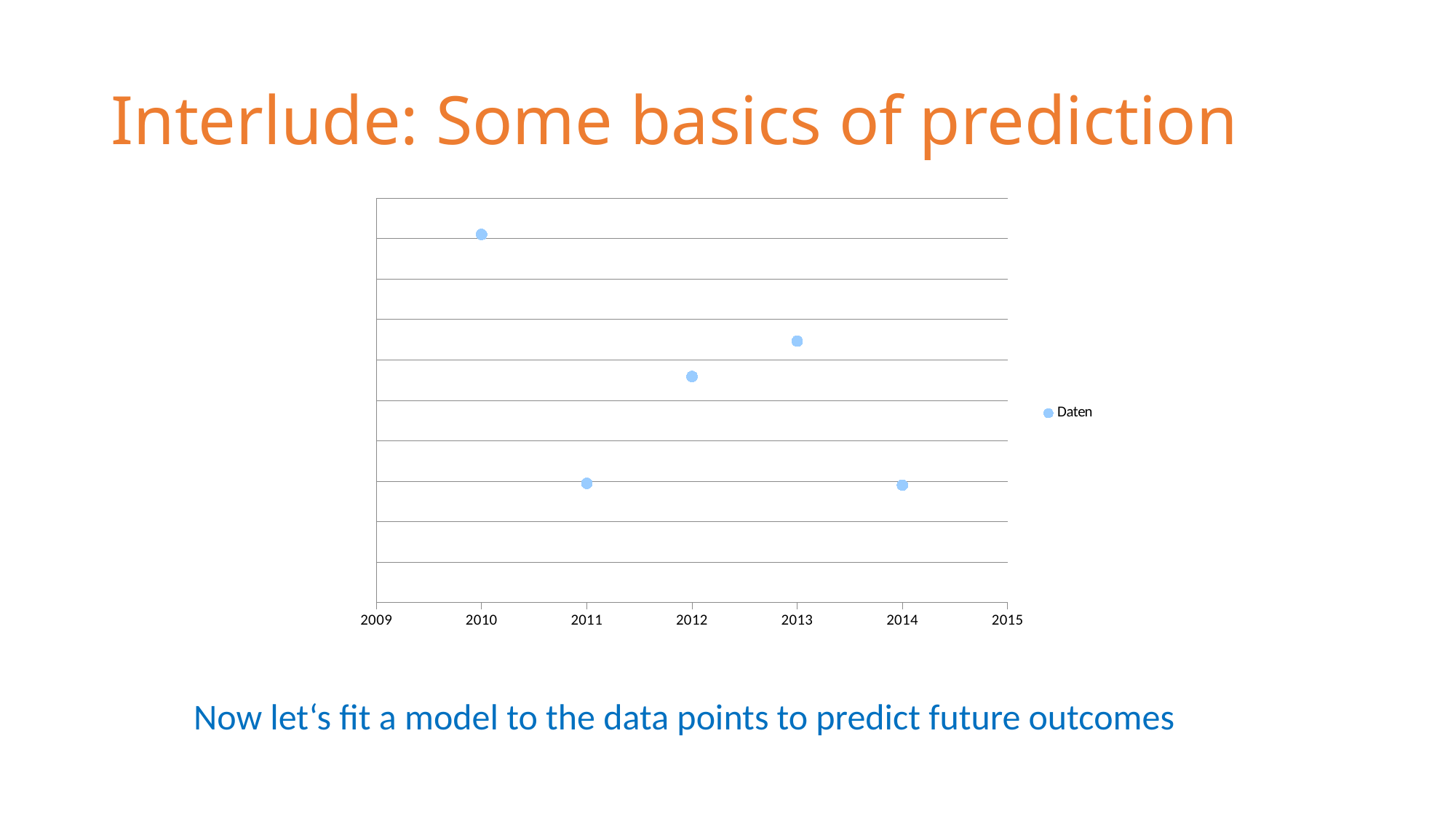
Does the value rise or fall from 2010 to 2011? fall What is the name of the series shown in the legend? Daten Which has the larger value, 2010 or 2011? 2010 How many data points are plotted in the chart? 5 Which year has the highest plotted value? 2010 What kind of chart is shown on the slide? scatter plot Which has the larger value, 2012 or 2013? 2013 What is the first year label shown on the x axis? 2009 Does the value rise or fall from 2011 to 2013? rise How many series does the legend list? 1 Which has the larger value, 2012 or 2014? 2012